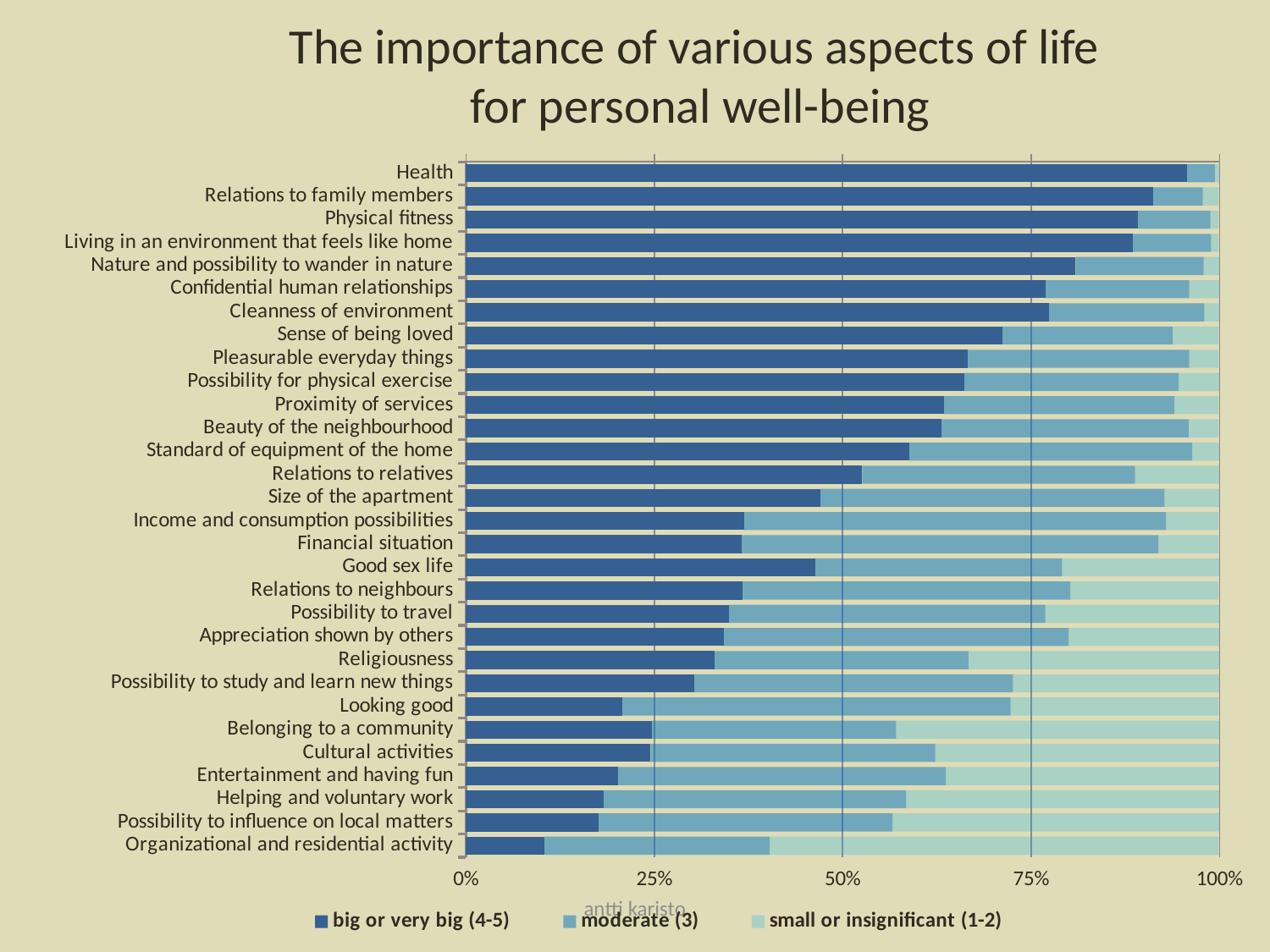
Is the 'big or very big (4-5)' share for Health greater or less than 75%? greater Is the 'big or very big (4-5)' share for Organizational and residential activity greater or less than 25%? less How many series does the legend list? 3 Which has a larger 'big or very big (4-5)' share: Good sex life or Looking good? Good sex life What kind of chart is shown on the slide? stacked bar chart Which aspect of life has the smallest 'big or very big (4-5)' share? Organizational and residential activity Going from the top category to the bottom category, does the 'big or very big (4-5)' share generally rise or fall? fall Which aspect of life has the largest 'big or very big (4-5)' share? Health What is the title of the chart? The importance of various aspects of life for personal well-being Is the 'big or very big (4-5)' share for Religiousness greater or less than 50%? less How many aspects of life (categories) are plotted on the chart? 30 Which has a larger 'small or insignificant (1-2)' share: Organizational and residential activity or Health? Organizational and residential activity